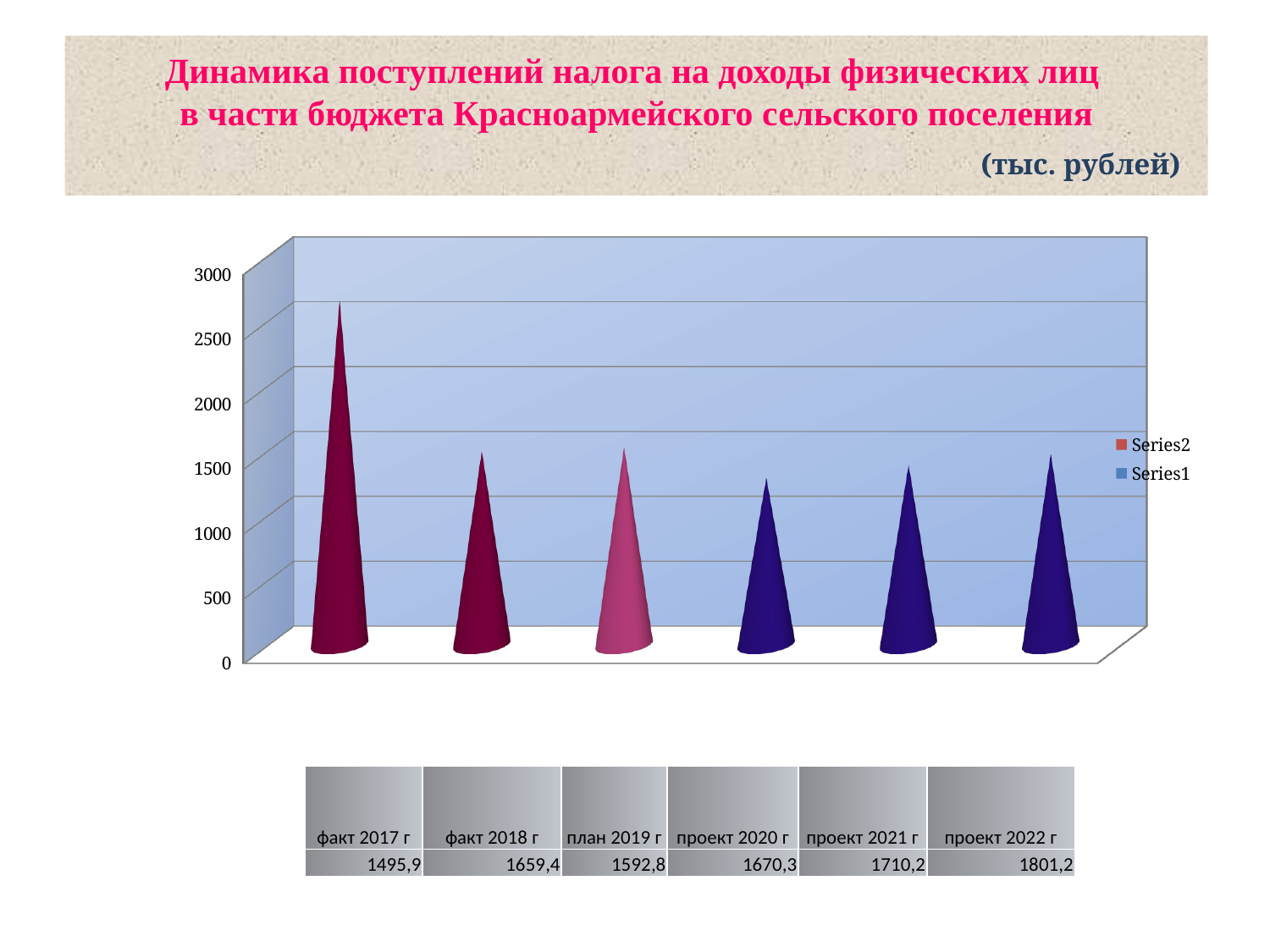
According to the data table below the chart, which is larger: the value for факт 2018 г or the value for план 2019 г? факт 2018 г Using the data table below the chart, what is the difference between the values for проект 2022 г and факт 2017 г? 305,3 How many series does the chart legend list? 2 How many categories are shown along the x axis of the chart? 6 Using the data table below the chart, what is the difference between the values for факт 2018 г and план 2019 г? 66,6 According to the data table below the chart, what is the value for проект 2021 г? 1710,2 According to the data table below the chart, what is the value for план 2019 г? 1592,8 According to the data table below the chart, which category has the lowest value? факт 2017 г According to the data table below the chart, which category has the highest value? проект 2022 г According to the data table below the chart, what is the value for проект 2022 г? 1801,2 According to the data table below the chart, what is the value for факт 2017 г? 1495,9 What unit is stated in the chart title? тыс. рублей